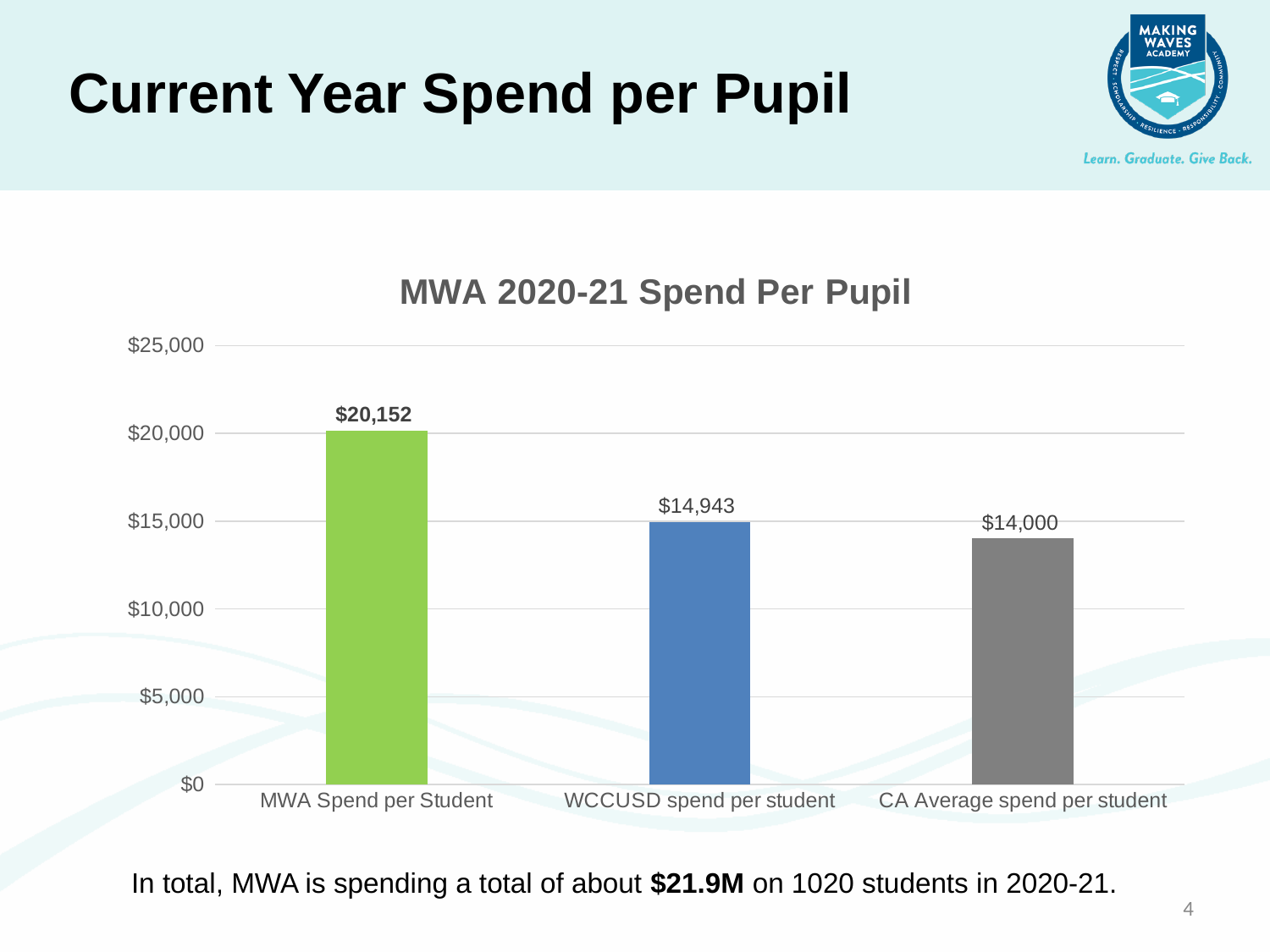
Is the value for MWA Spend per Student greater or less than $20,000? greater What is the value for MWA Spend per Student? $20,152 Which category has the lowest spend per pupil? CA Average spend per student What is the difference between WCCUSD spend per student and CA Average spend per student? $943 How many categories are shown in the chart? 3 Which is larger, MWA Spend per Student or CA Average spend per student? MWA Spend per Student Which category has the highest spend per pupil? MWA Spend per Student What kind of chart is shown on the slide? bar chart What is the title of the chart? MWA 2020-21 Spend Per Pupil What is the value for WCCUSD spend per student? $14,943 What is the value for CA Average spend per student? $14,000 What is the difference between MWA Spend per Student and WCCUSD spend per student? $5,209